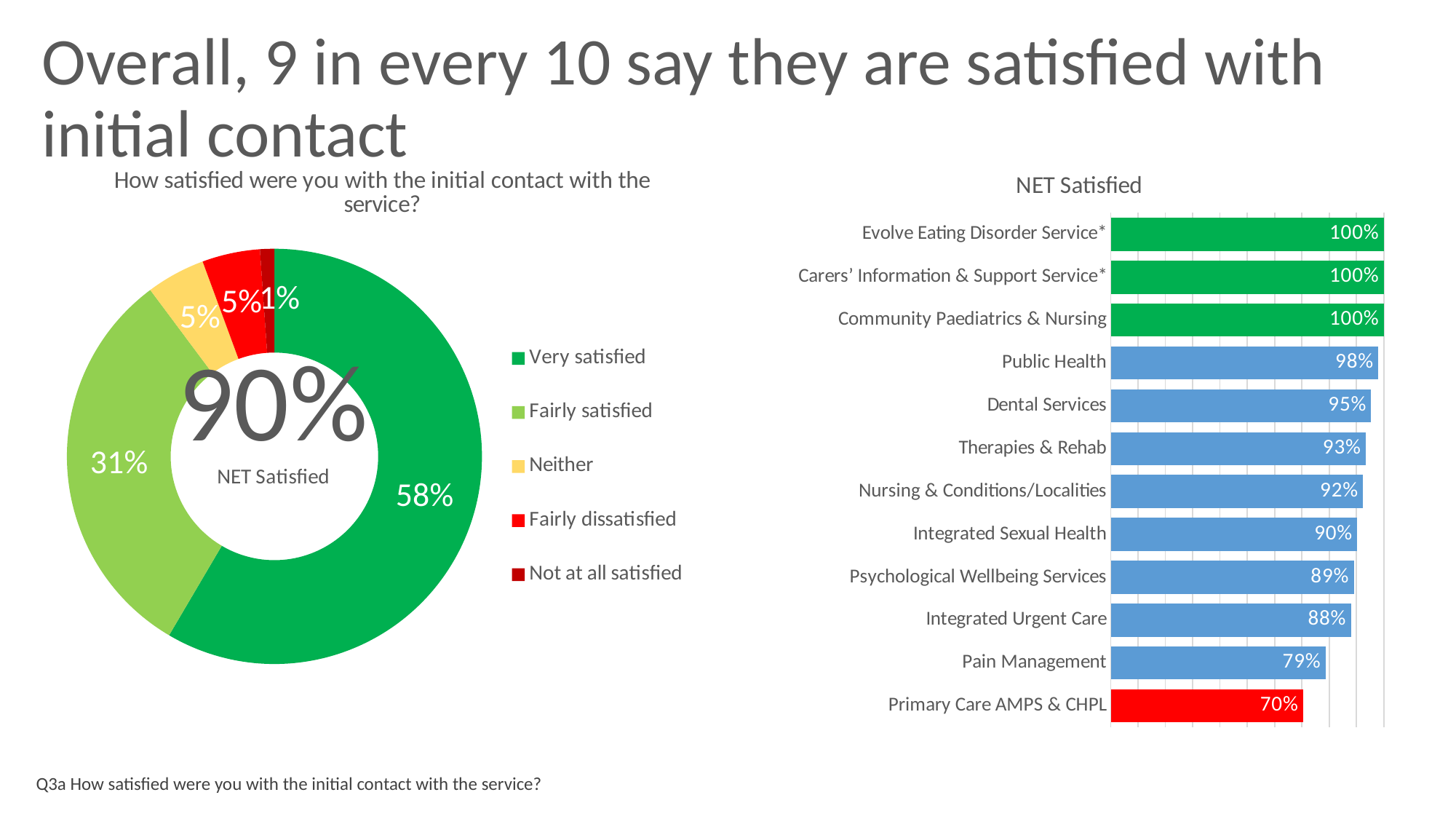
What NET Satisfied figure is shown in the centre of the 'How satisfied were you with the initial contact with the service?' chart? 90% In the 'How satisfied were you with the initial contact with the service?' chart, what share is Very satisfied? 58% In the 'NET Satisfied' bar chart, what is the value for Pain Management? 79% How many categories does the legend of the 'How satisfied were you with the initial contact with the service?' chart list? 5 What kind of chart is the 'NET Satisfied' chart? Bar chart In the 'NET Satisfied' bar chart, how many services are listed? 12 In the 'NET Satisfied' bar chart, which service has the lowest value? Primary Care AMPS & CHPL In the 'NET Satisfied' bar chart, what is the difference between Dental Services and Integrated Urgent Care? 7% In the 'NET Satisfied' bar chart, how many services have a value of 100%? 3 In the 'NET Satisfied' bar chart, what is the value for Public Health? 98% In the 'NET Satisfied' bar chart, which is larger: Therapies & Rehab or Psychological Wellbeing Services? Therapies & Rehab In the 'How satisfied were you with the initial contact with the service?' chart, what share is Fairly satisfied? 31%